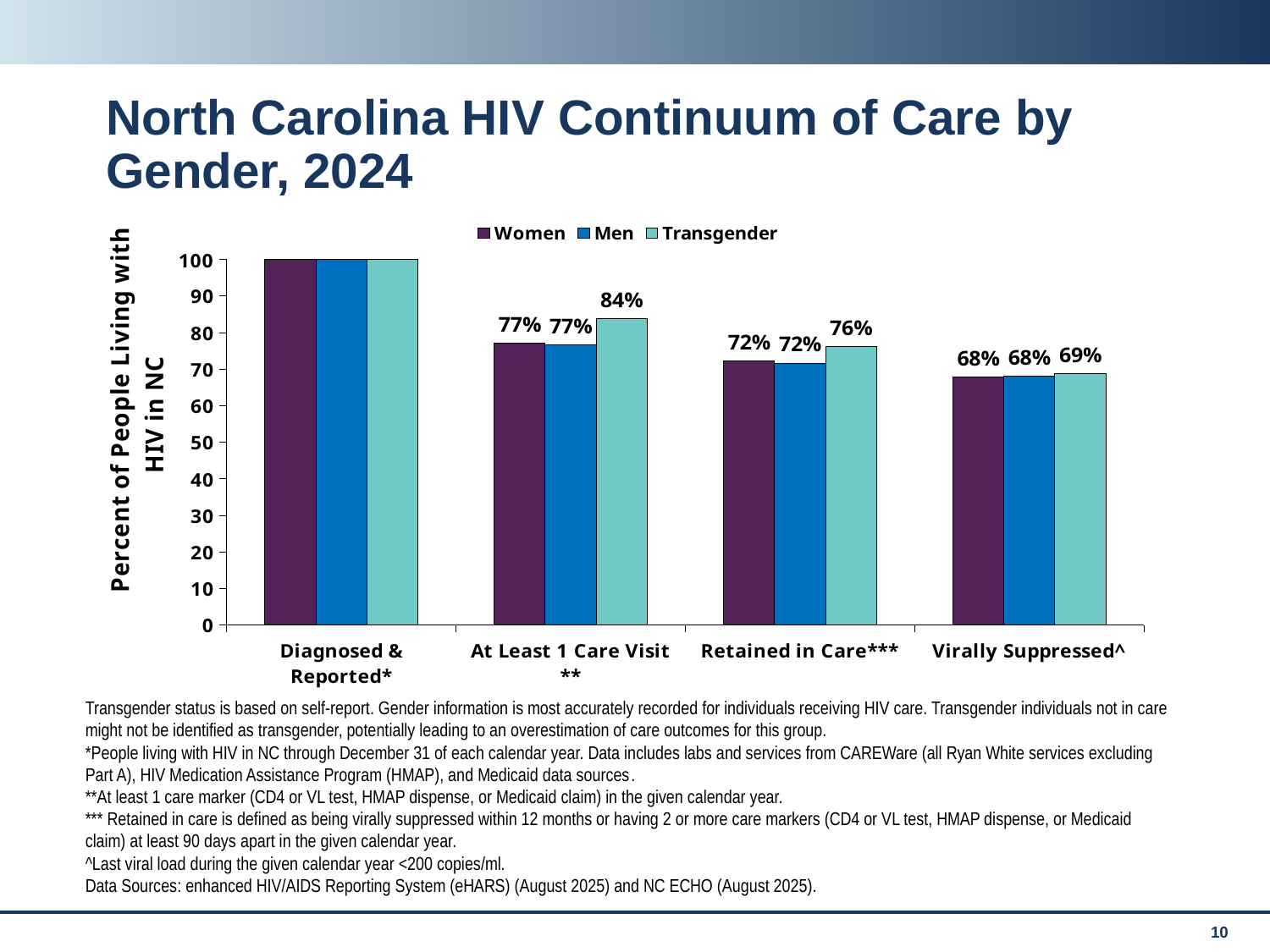
What is the difference between the Transgender and Women values for At Least 1 Care Visit? 7% What is the value for Men in the Virally Suppressed category? 68% How many categories are shown along the x axis? 4 Is the Transgender value for At Least 1 Care Visit larger or smaller than the Men value for the same category? larger What kind of chart is shown on the slide? Bar chart What percentage of transgender people living with HIV in NC had at least 1 care visit? 84% Which gender group has the highest value for Retained in Care? Transgender What is the value for Women in the Retained in Care category? 72% What is the label of the y axis? Percent of People Living with HIV in NC How many series does the legend list? 3 Do the values for Men rise or fall moving from Diagnosed & Reported to Virally Suppressed? Fall Is the value for Women in the Diagnosed & Reported category greater or less than 90? greater